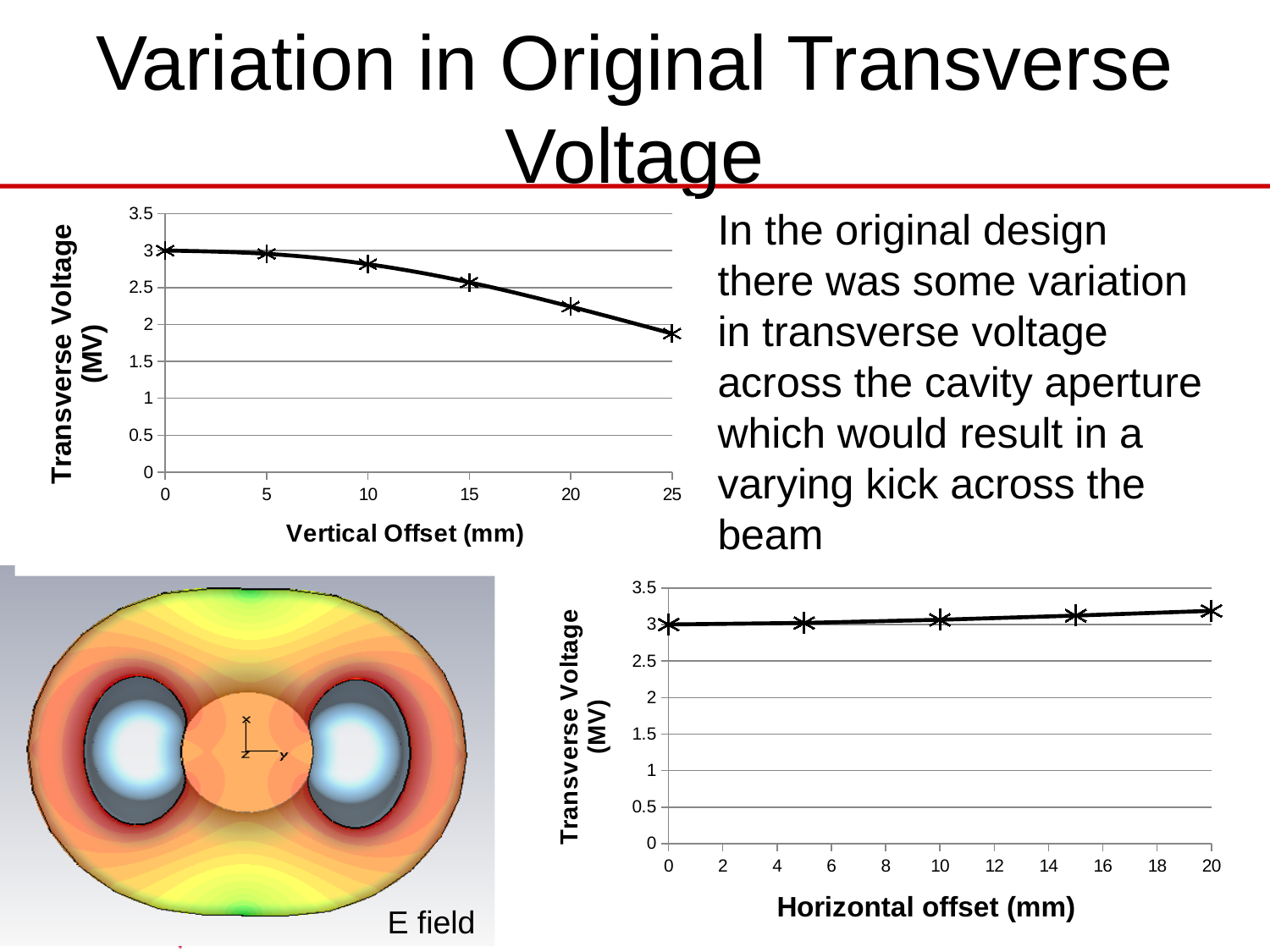
In the top-left chart (Vertical Offset), which has the higher transverse voltage: a vertical offset of 10 mm or 20 mm? 10 mm In the top-left chart (Vertical Offset), is the transverse voltage at a vertical offset of 15 mm greater or less than 2.5? greater In the bottom-right chart (Horizontal offset), how many data points are plotted? 5 In the bottom-right chart (Horizontal offset), is the transverse voltage at a horizontal offset of 20 mm greater or less than 3? greater What kind of chart is the top-left chart with Vertical Offset on the x axis? line chart In the top-left chart (Vertical Offset), do the transverse voltage values rise or fall as the vertical offset increases? fall In the top-left chart (Vertical Offset), is the transverse voltage at a vertical offset of 25 mm greater or less than 2? less In the top-left chart (Vertical Offset), how many data points are plotted? 6 What is the x-axis title of the bottom-right chart? Horizontal offset (mm) In the bottom-right chart (Horizontal offset), do the transverse voltage values rise or fall as the horizontal offset increases? rise In the top-left chart (Vertical Offset), at which vertical offset is the transverse voltage lowest? 25 What is the y-axis title of the top-left chart? Transverse Voltage (MV)